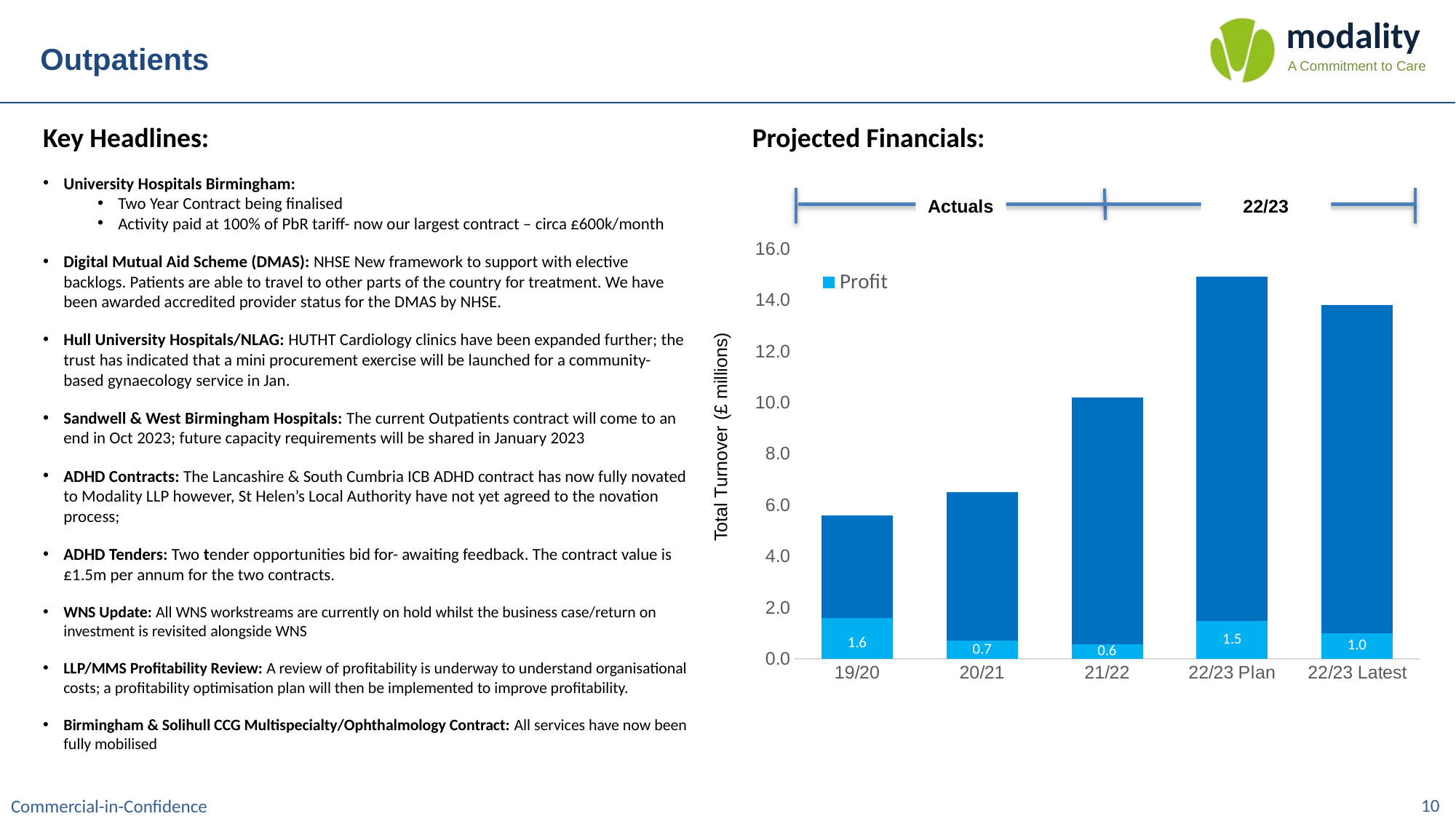
What is the Profit value for 19/20? 1.6 What is the difference between the Profit values for 22/23 Plan and 22/23 Latest? 0.5 Is the total bar height for 20/21 greater or less than 8.0? less What kind of chart is shown under Projected Financials? Stacked bar chart What is the Profit value for 22/23 Plan? 1.5 Which category has the highest Profit value? 19/20 Is the total bar height for 22/23 Plan greater or less than 14.0? greater How many categories are shown on the x axis? 5 Which category has the lowest Profit value? 21/22 What is the Profit value for 21/22? 0.6 What is the label on the y axis of the chart? Total Turnover (£ millions) Which has the larger Profit value, 20/21 or 22/23 Latest? 22/23 Latest